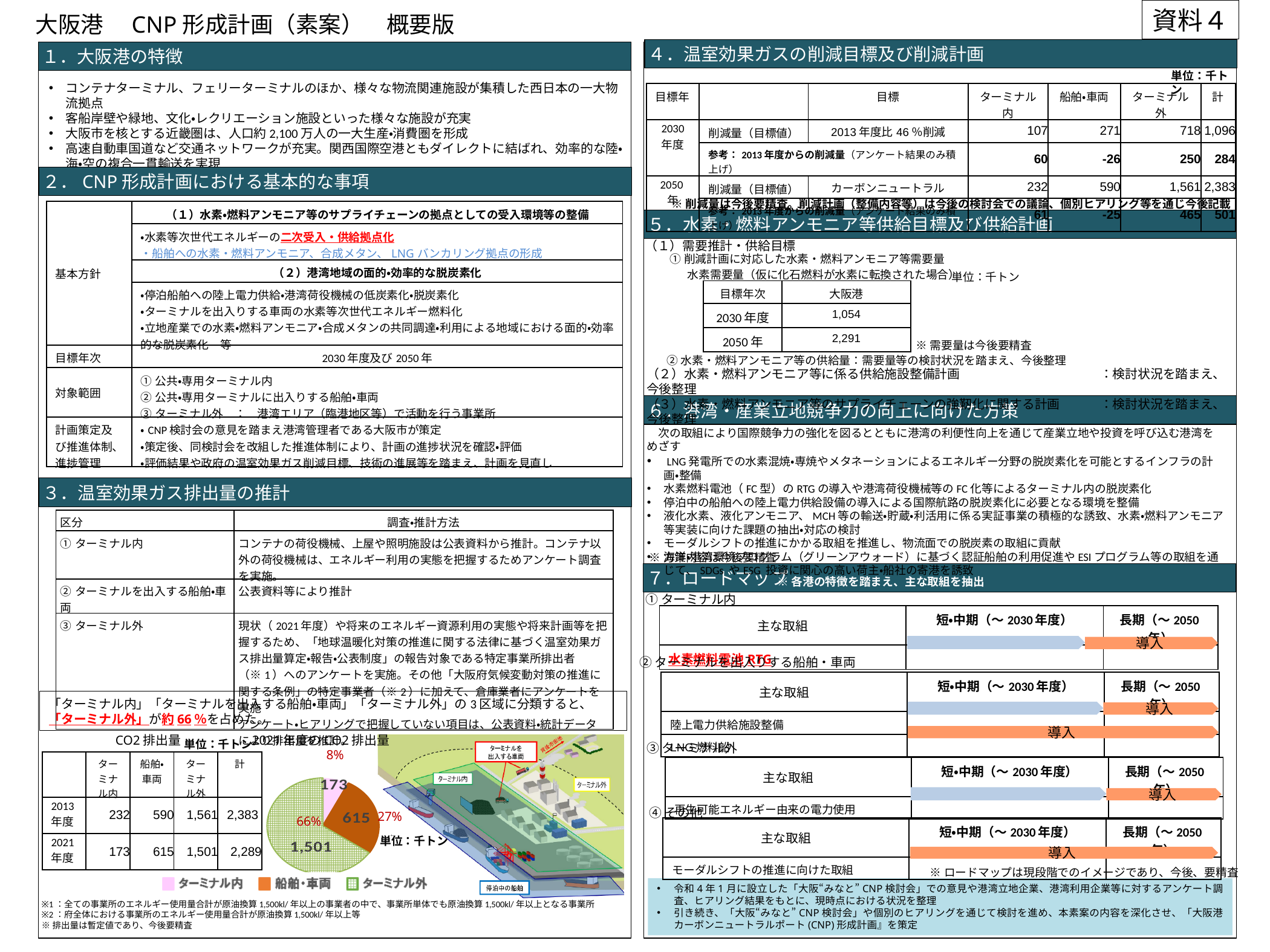
In the 2021年度のCO2排出量 pie chart, what share of the total does ターミナル内 account for? 8% In the 2021年度のCO2排出量 pie chart, what is the value for ターミナル外? 1,501 In the 2021年度のCO2排出量 pie chart, what share of the total does ターミナル外 account for? 66% In the 2021年度のCO2排出量 pie chart, which category has the smallest slice? ターミナル内 How many categories are shown in the 2021年度のCO2排出量 pie chart? 3 In the 2021年度のCO2排出量 pie chart, which category has the largest slice? ターミナル外 In the 2021年度のCO2排出量 pie chart, what is the value for ターミナル内? 173 In the 2021年度のCO2排出量 pie chart, what is the difference between the values for 船舶・車両 and ターミナル内? 442 What kind of chart is the 2021年度のCO2排出量 chart on the slide? pie chart What unit is stated for the values in the 2021年度のCO2排出量 pie chart? 千トン In the 2021年度のCO2排出量 pie chart, what share of the total does 船舶・車両 account for? 27% In the 2021年度のCO2排出量 pie chart, what is the value for 船舶・車両? 615